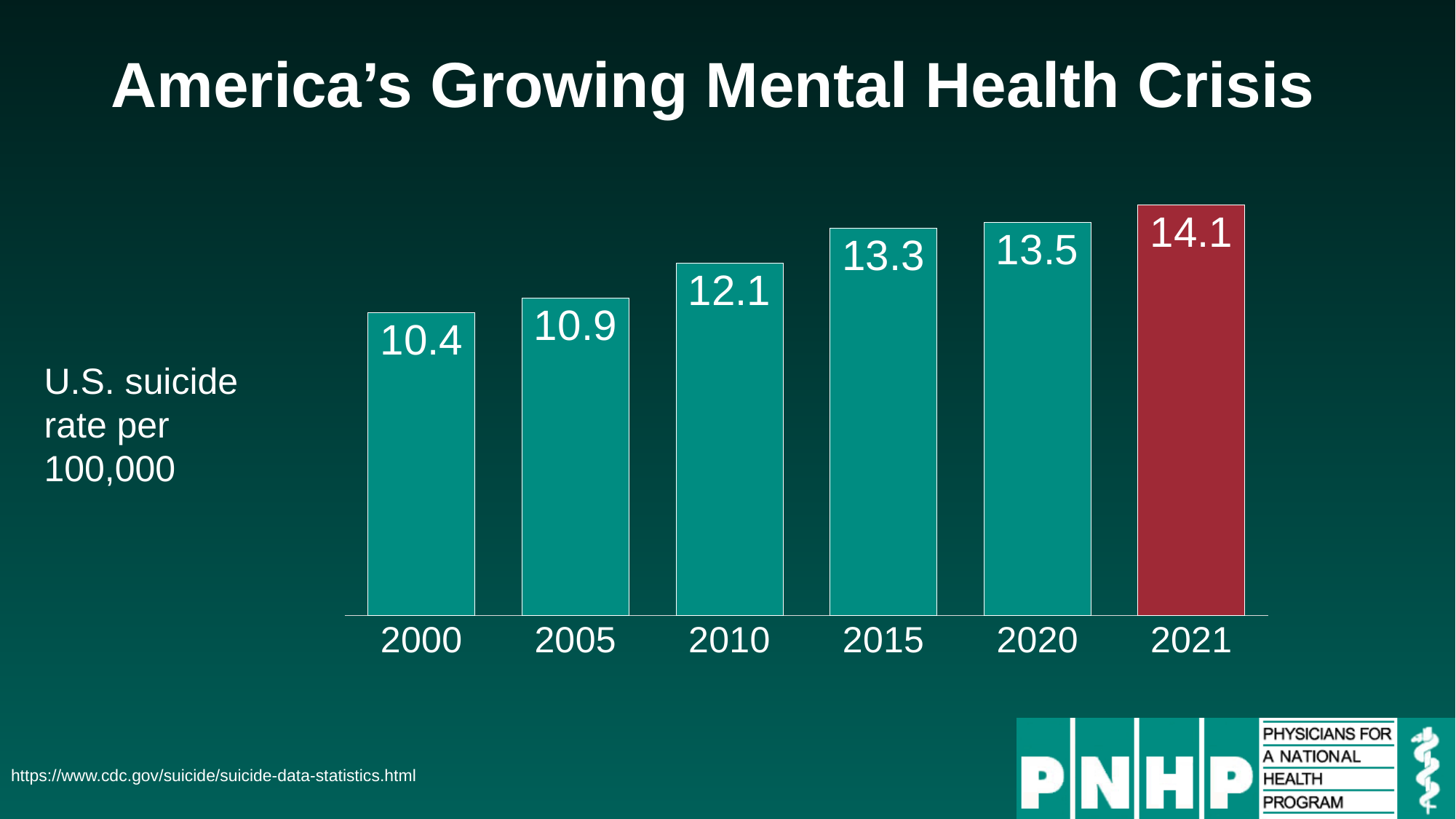
Which bar is coloured red rather than teal? 2021 What is the difference between the suicide rate in 2020 and the rate in 2015? 0.2 What is the U.S. suicide rate per 100,000 shown for 2021? 14.1 What is the U.S. suicide rate per 100,000 shown for 2010? 12.1 What is the U.S. suicide rate per 100,000 shown for 2000? 10.4 What kind of chart is shown on the slide? Bar chart How many years are shown on the chart? 6 What is the difference between the suicide rate in 2021 and the rate in 2000? 3.7 Which year has the lowest U.S. suicide rate on the chart? 2000 Which year has the highest U.S. suicide rate on the chart? 2021 Do the suicide rates rise or fall from 2000 to 2021? Rise Which year has a higher suicide rate, 2005 or 2015? 2015